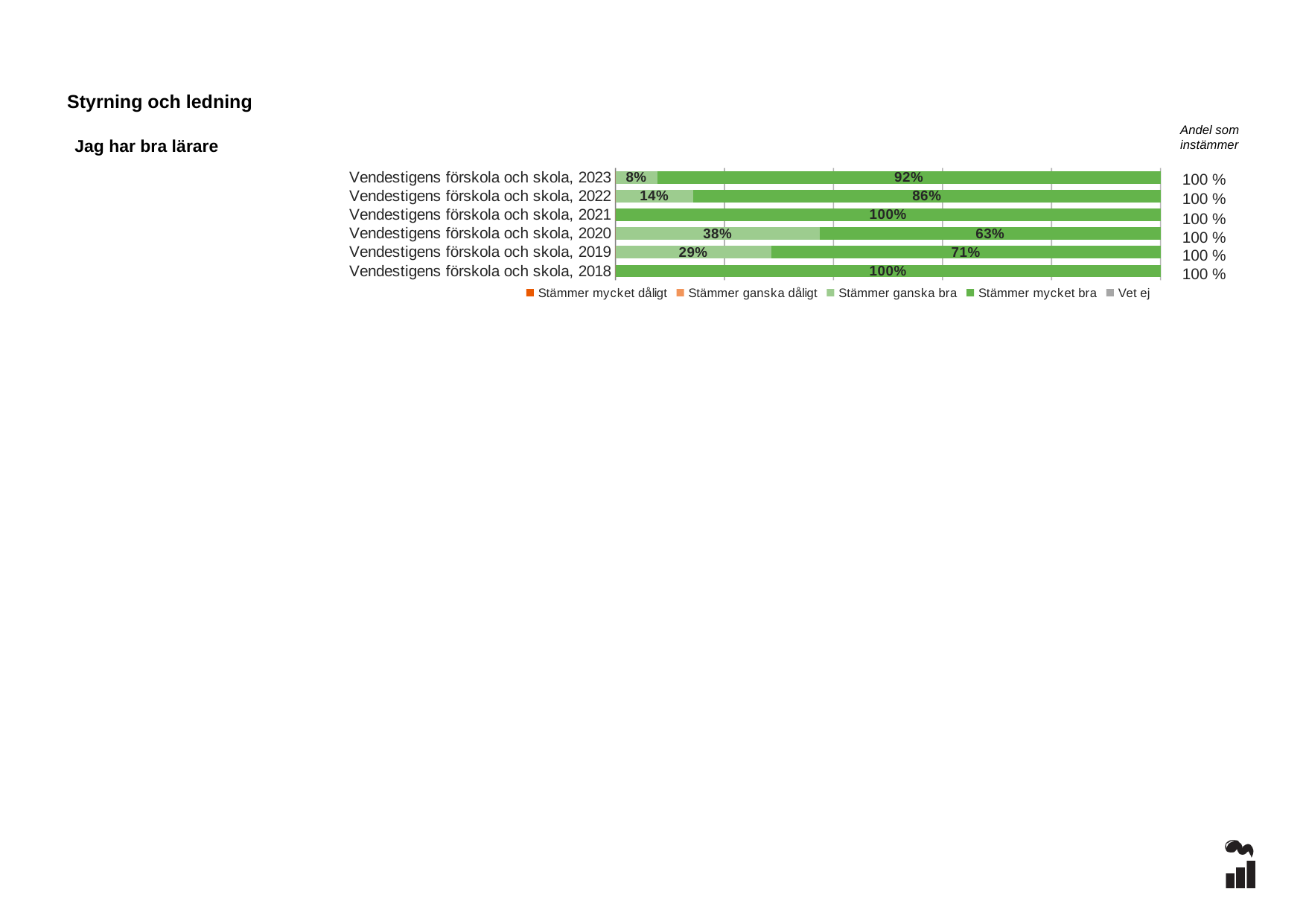
How many series does the legend list? 5 What is the value of 'Stämmer mycket bra' for Vendestigens förskola och skola, 2023? 92% What is the value of 'Stämmer mycket bra' for Vendestigens förskola och skola, 2019? 71% What kind of chart is shown on the slide? Stacked bar chart What is the value of 'Stämmer ganska bra' for Vendestigens förskola och skola, 2020? 38% Which is larger: 'Stämmer mycket bra' for 2020 or for 2019? 2019 What is the 'Andel som instämmer' value shown for Vendestigens förskola och skola, 2020? 100 % What is the value of 'Stämmer ganska bra' for Vendestigens förskola och skola, 2022? 14% Which years show 100% for 'Stämmer mycket bra'? 2021 and 2018 What is the difference between the 'Stämmer mycket bra' values for 2023 and 2022? 6 percentage points How many categories (bars) does the chart show? 6 Which year has the highest 'Stämmer ganska bra' value? 2020